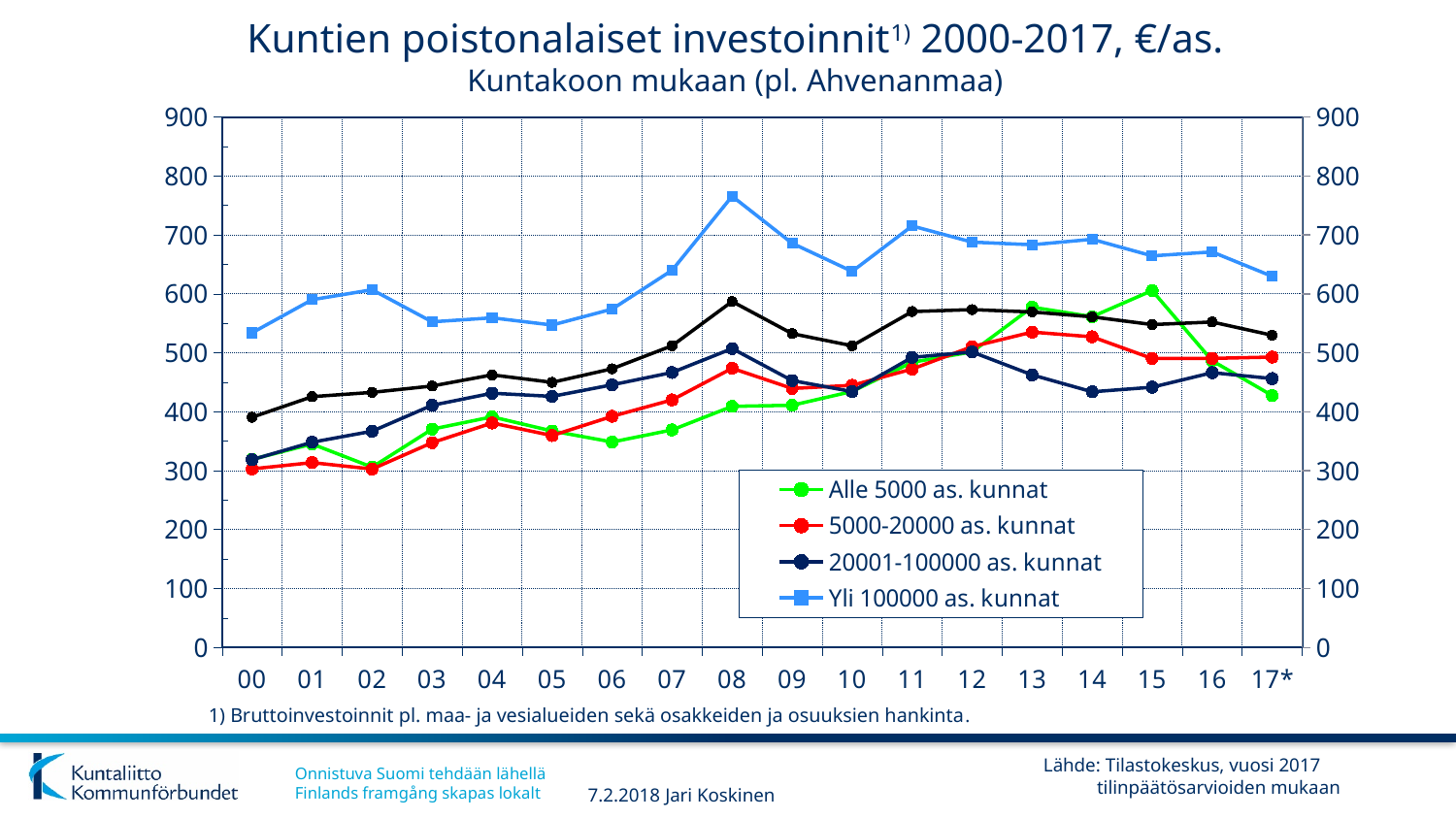
Which series has the lowest value in 06? Alle 5000 as. kunnat How many series does the legend list? 4 Is the value for 5000-20000 as. kunnat in 00 greater or less than 400? less Which series is drawn with light blue square markers? Yli 100000 as. kunnat Does the Alle 5000 as. kunnat series rise or fall from 15 to 17*? fall Is the value for Yli 100000 as. kunnat in 08 greater or less than 700? greater How many years are shown along the x axis? 18 In which year does the Yli 100000 as. kunnat series reach its highest value? 08 What kind of chart is shown on the slide? line chart In 15, which is higher: Alle 5000 as. kunnat or 5000-20000 as. kunnat? Alle 5000 as. kunnat Which series has the highest value in 08? Yli 100000 as. kunnat